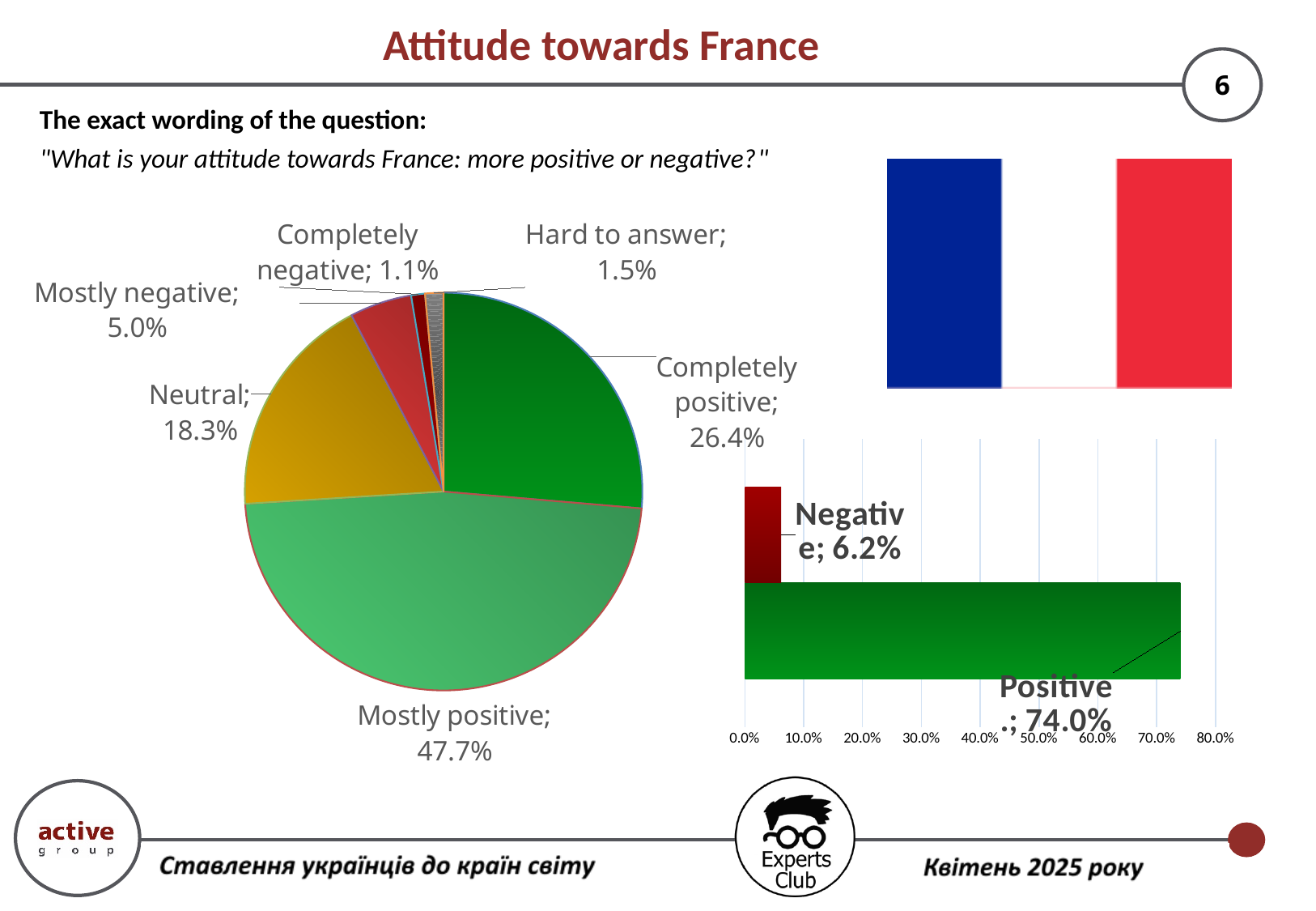
In the pie chart, what share is labelled for Hard to answer? 1.5% In the pie chart, what share is labelled for Neutral? 18.3% In the pie chart, what share is labelled for Completely positive? 26.4% In the bar chart on the right, what is the value for Negative? 6.2% In the pie chart, how many slices are there? 6 In the pie chart, which category has the largest slice? Mostly positive In the pie chart, what is the difference between Mostly positive and Completely positive? 21.3% In the pie chart, which category has the smallest slice? Completely negative In the bar chart on the right, what is the value for Positive? 74.0% What kind of chart is the chart on the right side of the slide? bar chart In the pie chart, which is larger: Mostly negative or Neutral? Neutral In the pie chart, what share is labelled for Mostly positive? 47.7%